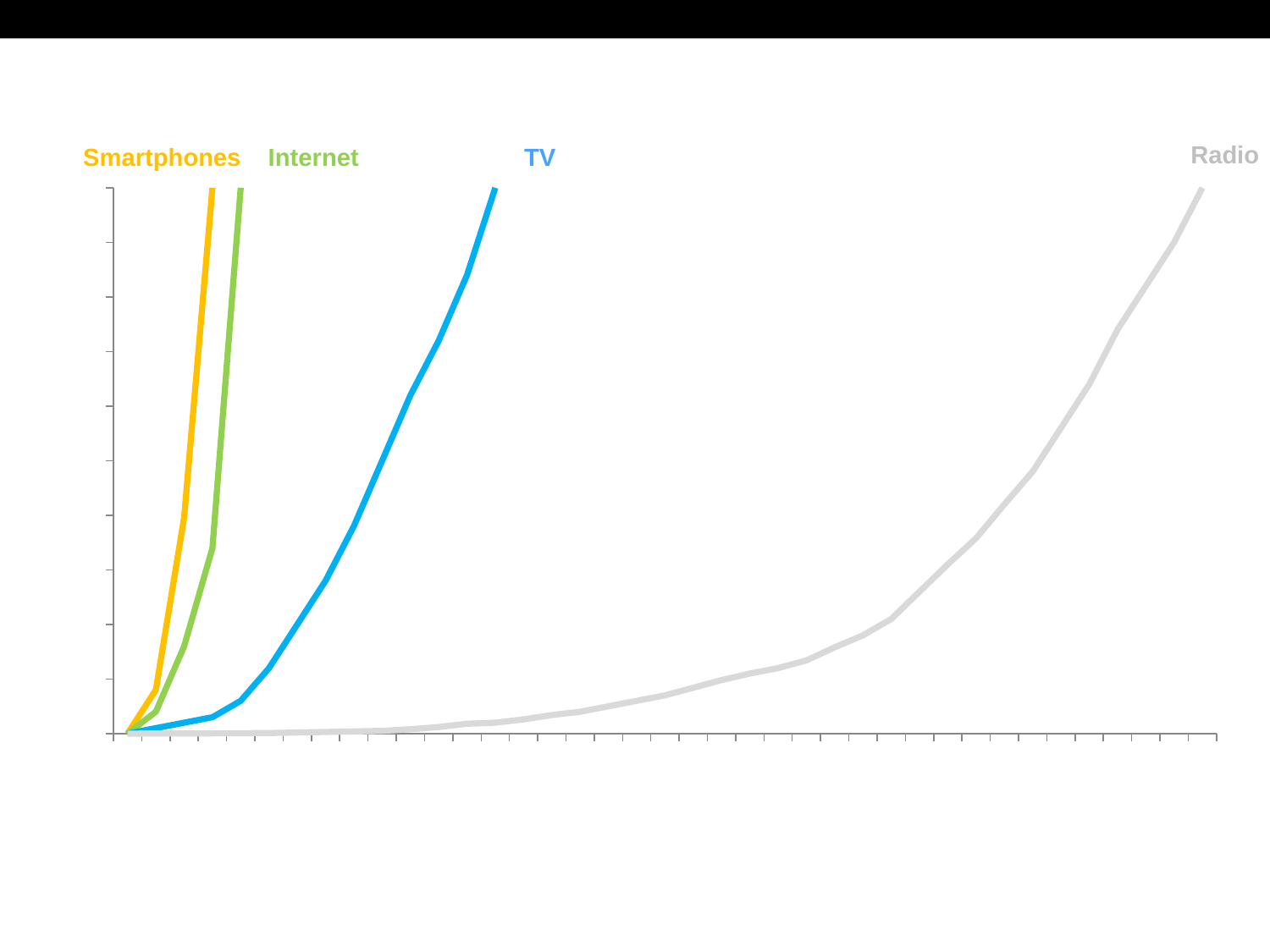
What kind of chart is shown on the slide? line chart Which series takes the longest along the x axis to reach the top of the chart? Radio Which line reaches the top of the chart first along the x axis, Smartphones or Radio? Smartphones Do the values for TV rise or fall along the x axis? rise Do the values for Radio rise or fall along the x axis? rise Which series reaches the top of the chart in the shortest distance along the x axis? Smartphones Which series is drawn in grey? Radio What colour is the Smartphones line? yellow How many series are plotted on the chart? 4 Which line reaches the top of the chart first along the x axis, Internet or TV? Internet